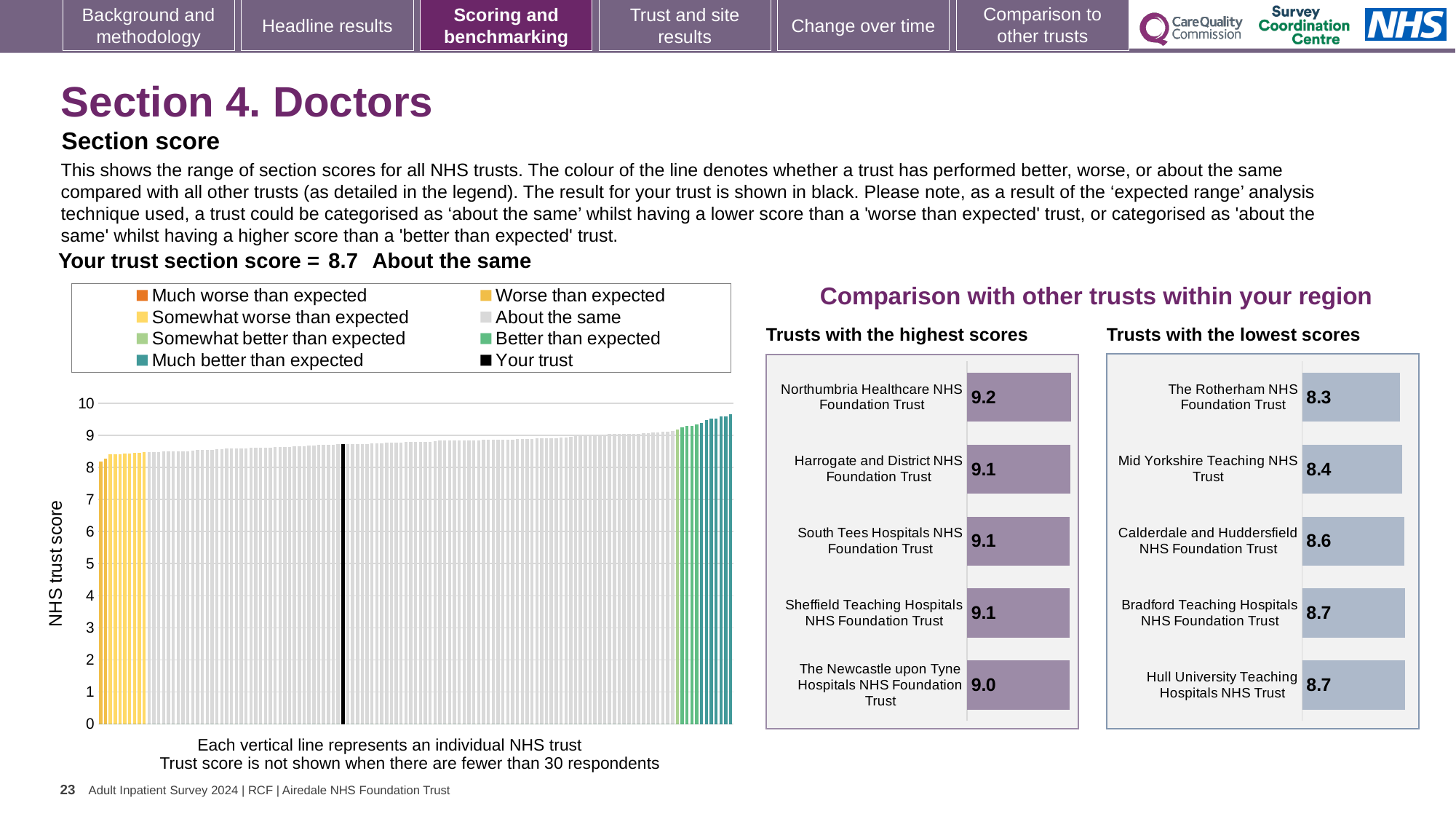
In the 'Trusts with the highest scores' chart, what is the score for Northumbria Healthcare NHS Foundation Trust? 9.2 In the 'Trusts with the highest scores' chart, what is the difference between the scores of Northumbria Healthcare NHS Foundation Trust and The Newcastle upon Tyne Hospitals NHS Foundation Trust? 0.2 In the 'Trusts with the lowest scores' chart, which has the larger score: Mid Yorkshire Teaching NHS Trust or Calderdale and Huddersfield NHS Foundation Trust? Calderdale and Huddersfield NHS Foundation Trust In the 'Trusts with the highest scores' chart, which trust has the highest score? Northumbria Healthcare NHS Foundation Trust In the 'Trusts with the lowest scores' chart, what is the difference between the scores of Bradford Teaching Hospitals NHS Foundation Trust and The Rotherham NHS Foundation Trust? 0.4 In the 'Trusts with the highest scores' chart, what is the score for The Newcastle upon Tyne Hospitals NHS Foundation Trust? 9.0 In the NHS trust score chart on the left, how many entries does the legend list? 8 In the 'Trusts with the highest scores' chart, how many trusts are listed? 5 In the 'Trusts with the lowest scores' chart, what is the score for The Rotherham NHS Foundation Trust? 8.3 In the 'Trusts with the lowest scores' chart, which trust has the lowest score? The Rotherham NHS Foundation Trust In the NHS trust score chart on the left, do the bar heights rise or fall from left to right? rise In the 'Trusts with the lowest scores' chart, what is the score for Calderdale and Huddersfield NHS Foundation Trust? 8.6